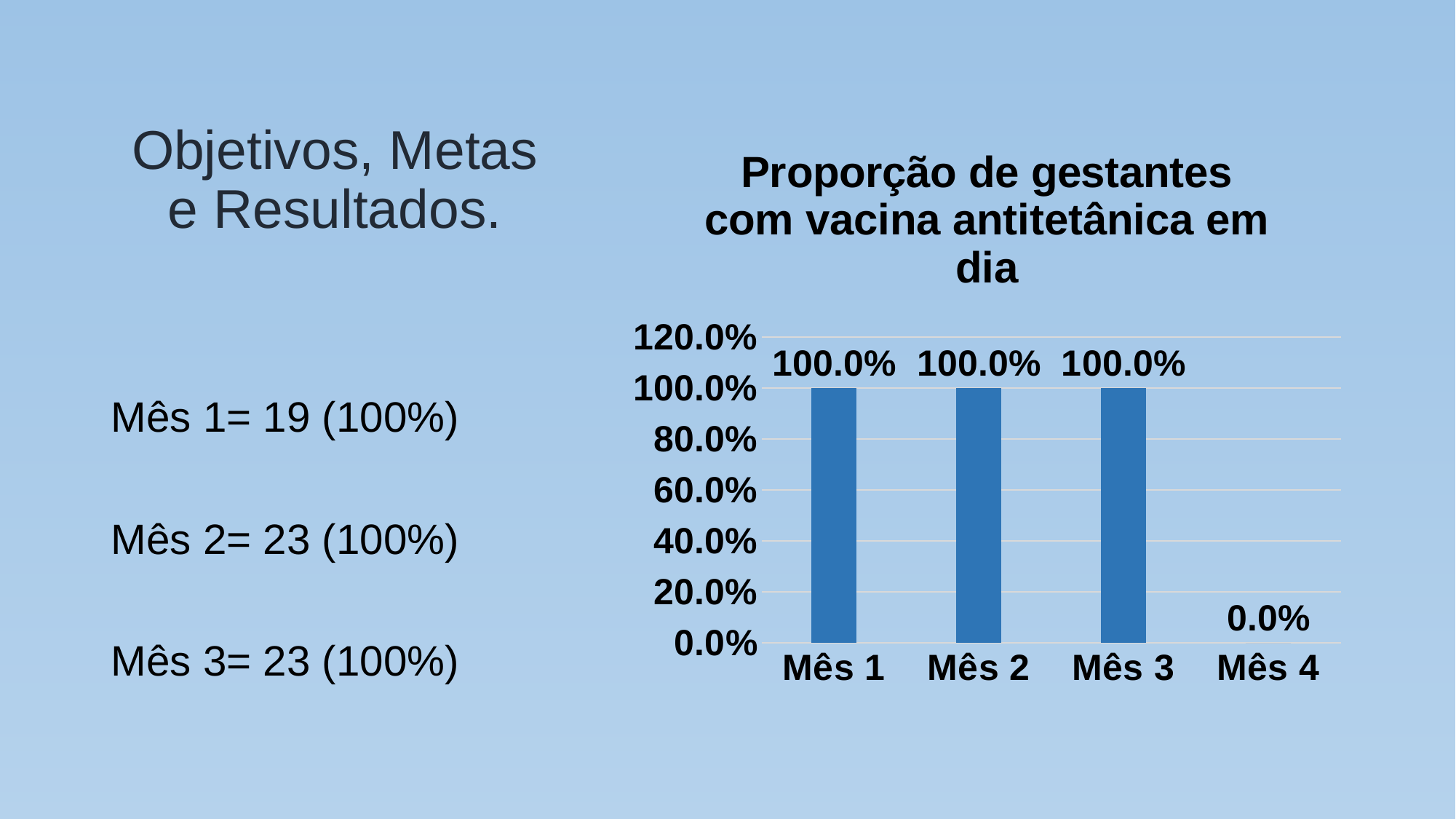
What kind of chart is shown? bar chart Which is larger, the value for Mês 1 or the value for Mês 4? Mês 1 What is the value for Mês 3? 100.0% How many categories are shown on the x axis? 4 What is the highest tick value shown on the y axis? 120.0% What is the value for Mês 4? 0.0% Is the value for Mês 2 greater or less than 80.0%? greater Which category has the lowest value? Mês 4 What is the value for Mês 1? 100.0% What is the value for Mês 2? 100.0% What is the title of the chart? Proporção de gestantes com vacina antitetânica em dia What is the difference between the values for Mês 3 and Mês 4? 100.0%